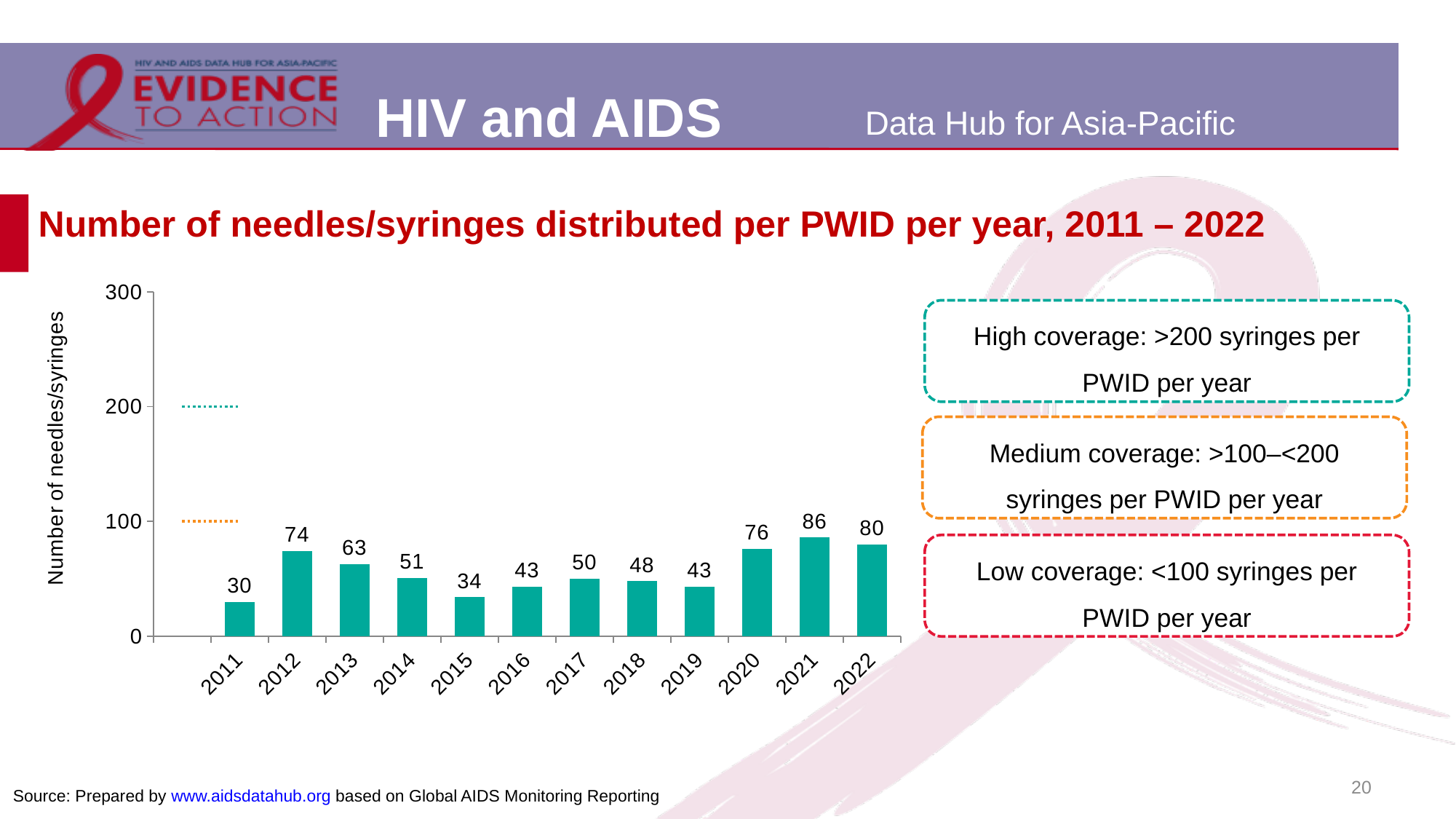
How many years are shown on the x axis of the chart? 12 Which year has the lowest number of needles/syringes distributed per PWID? 2011 Is the value for 2021 greater or less than 100? less What is the number of needles/syringes distributed per PWID in 2021? 86 What is the label of the y axis of the chart? Number of needles/syringes Which year has the highest number of needles/syringes distributed per PWID? 2021 What is the number of needles/syringes distributed per PWID in 2016? 43 What is the number of needles/syringes distributed per PWID in 2011? 30 What is the difference between the values for 2022 and 2011? 50 What kind of chart is shown on the slide? bar chart Which year has a larger value, 2012 or 2020? 2020 Did the number of needles/syringes distributed per PWID rise or fall from 2019 to 2021? rise